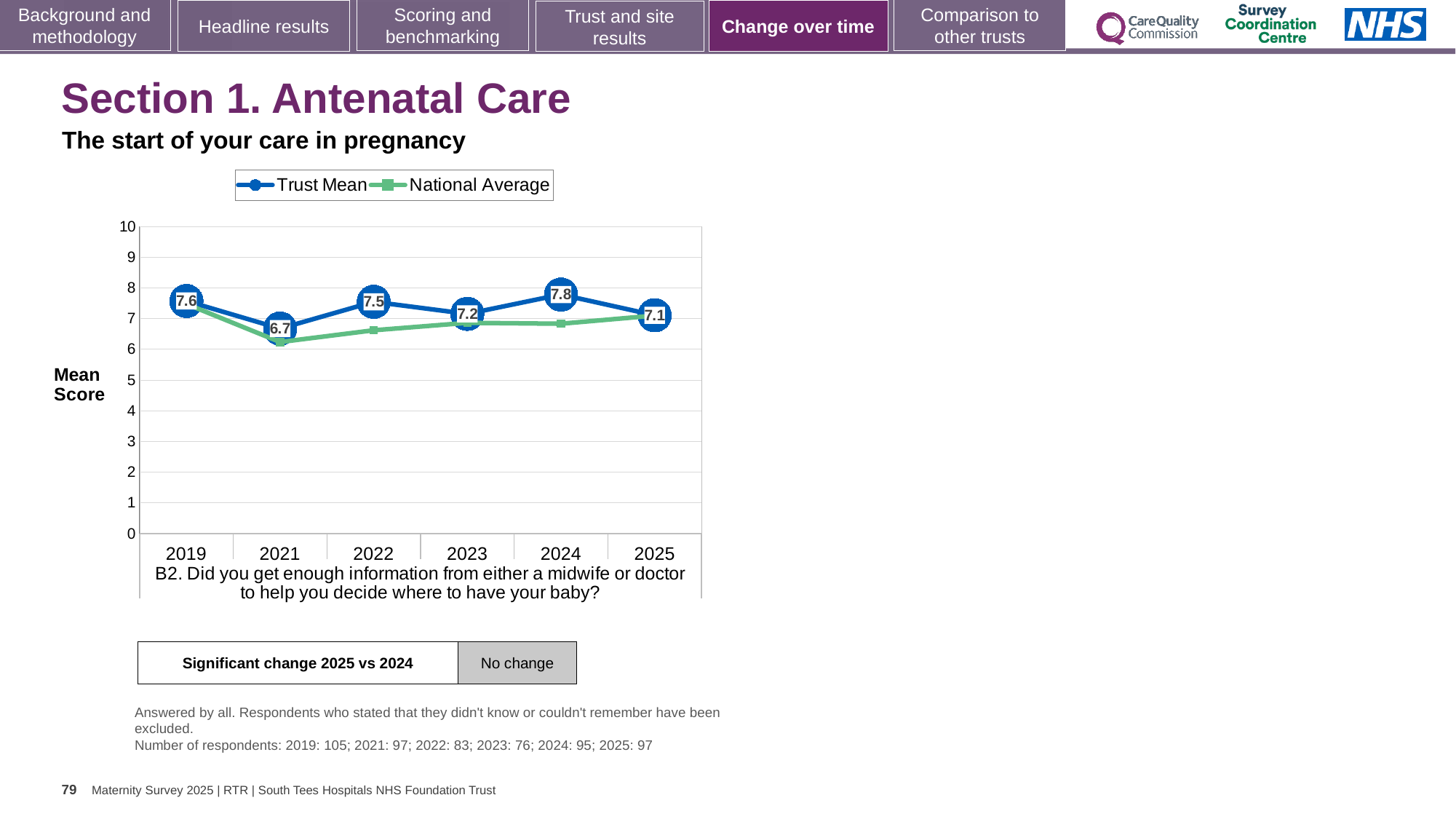
In which year is the Trust Mean lowest? 2021 What is the Trust Mean for 2021? 6.7 Is the National Average for 2021 greater or less than 7? less How many years are shown on the x axis? 6 What kind of chart is shown? line chart Which is larger, the Trust Mean in 2019 or in 2022? 2019 How many series does the legend list? 2 Does the Trust Mean rise or fall from 2024 to 2025? fall In which year is the Trust Mean highest? 2024 What is the Trust Mean for 2024? 7.8 What is the difference between the Trust Mean in 2024 and in 2025? 0.7 What is the Trust Mean for 2025? 7.1